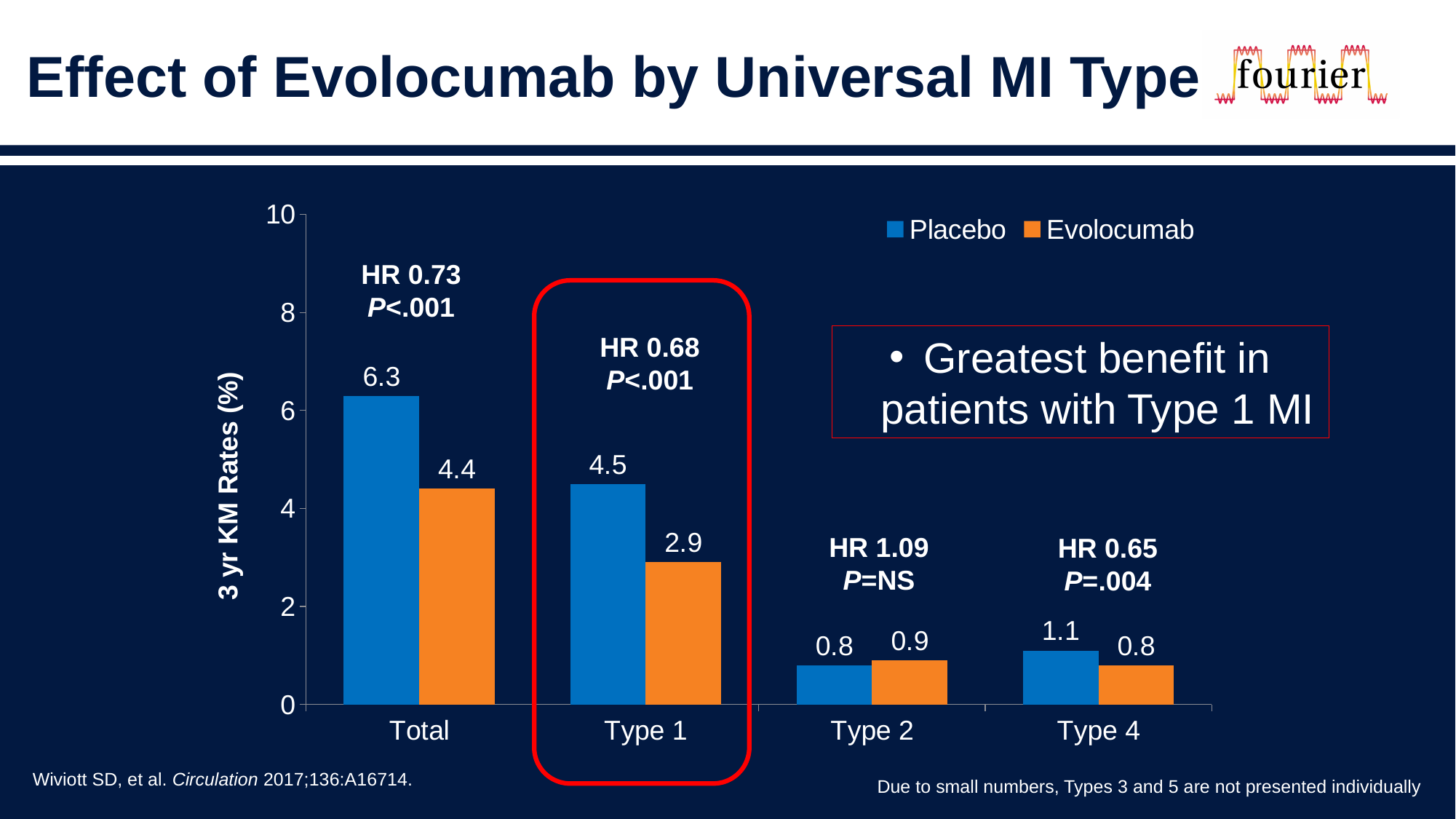
In the Type 2 group, which is larger, the Placebo rate or the Evolocumab rate? Evolocumab What is the 3 yr KM rate for Evolocumab in the Type 1 group? 2.9 What is the difference between the Placebo and Evolocumab rates in the Total group? 1.9 Which category has the lowest Placebo rate? Type 2 What is the 3 yr KM rate for Placebo in the Type 4 group? 1.1 What is the difference between the Placebo and Evolocumab rates in the Type 1 group? 1.6 What is the 3 yr KM rate for Evolocumab in the Type 2 group? 0.9 What is the 3 yr KM rate for Placebo in the Total group? 6.3 What kind of chart is shown on the slide? Bar chart Which MI type category has the highest Placebo rate? Total How many series does the legend list? 2 How many categories are shown on the x axis? 4